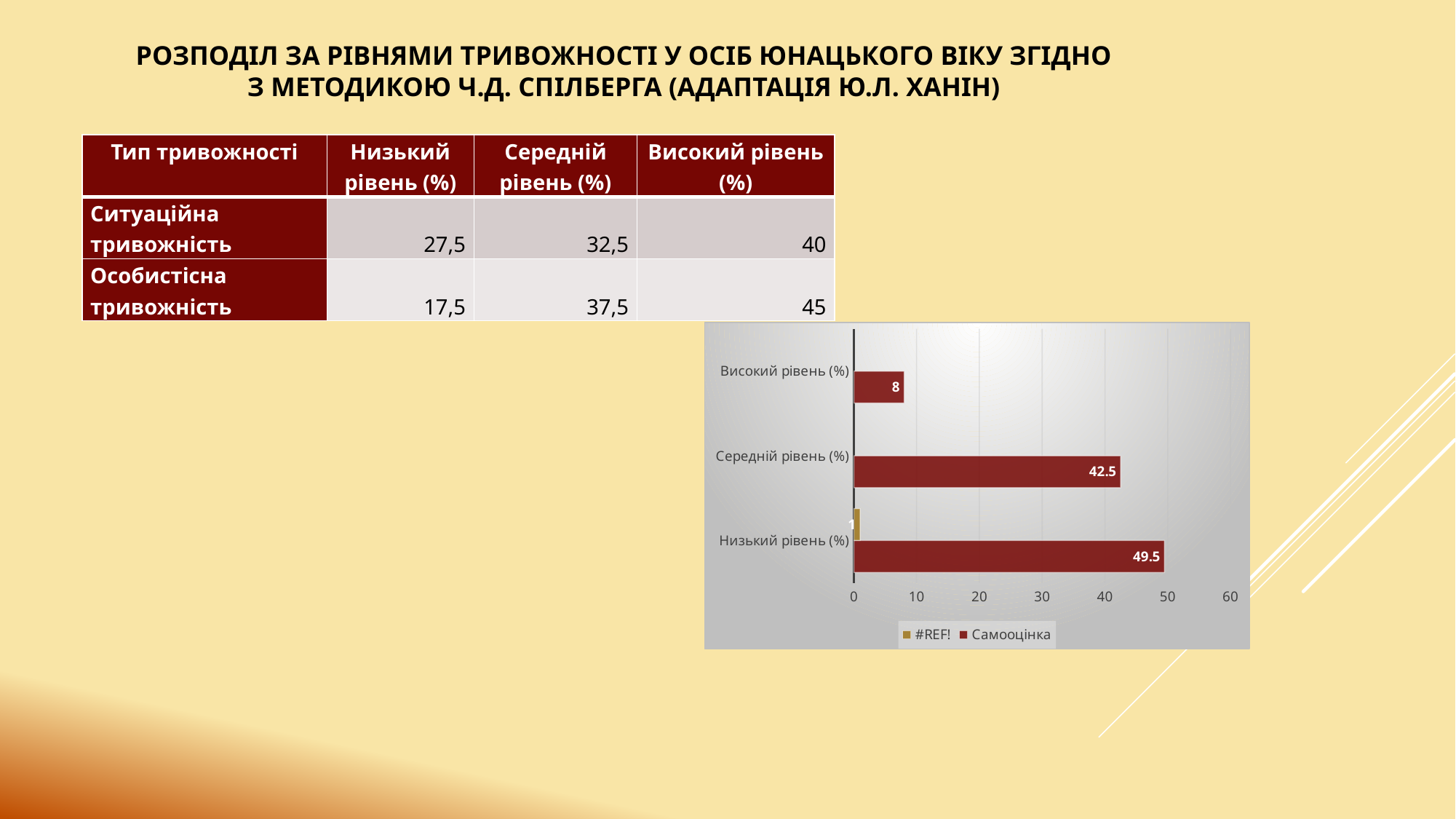
In the chart, is the Самооцінка value for Середній рівень (%) larger or smaller than the value for Високий рівень (%)? larger What kind of chart is shown on the slide? bar chart How many categories are shown on the chart's vertical axis? 3 In the chart, which category has the lowest Самооцінка value? Високий рівень (%) In the chart, what is the Самооцінка value for Високий рівень (%)? 8 In the chart, what is the difference between the Самооцінка values for Низький рівень (%) and Середній рівень (%)? 7 How many series does the chart's legend list? 2 In the chart, what is the Самооцінка value for Середній рівень (%)? 42.5 In the chart, which category has the highest Самооцінка value? Низький рівень (%) What are the two series names listed in the chart's legend? #REF! and Самооцінка In the chart, what is the difference between the Самооцінка values for Середній рівень (%) and Високий рівень (%)? 34.5 In the chart, what is the Самооцінка value for Низький рівень (%)? 49.5